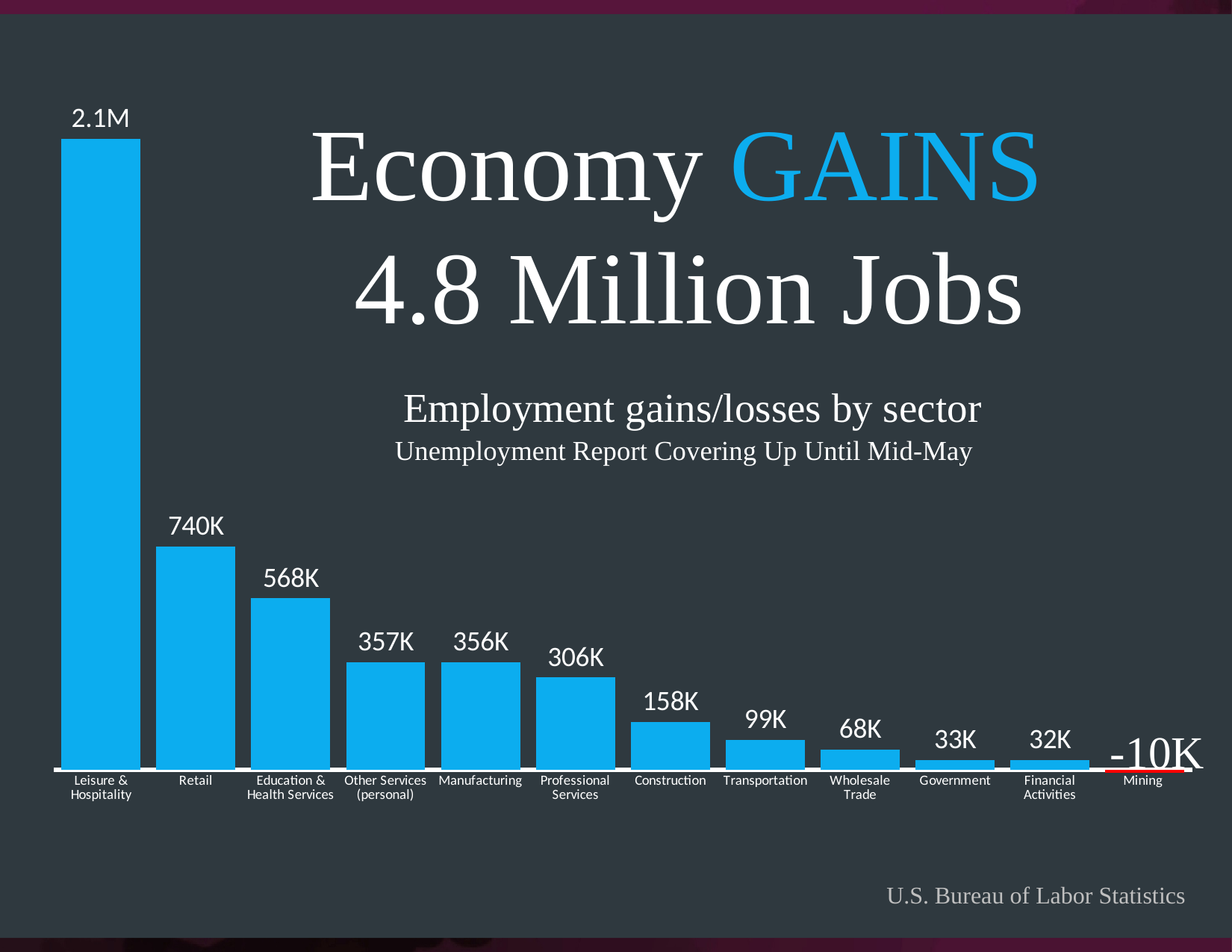
What is the value for Retail? 740K What kind of chart is shown on the slide? Bar chart Which is larger, the value for Transportation or the value for Wholesale Trade? Transportation How many sectors are shown in the chart? 12 Which sector has the lowest value? Mining What is the value for Construction? 158K What is the source cited for the chart data? U.S. Bureau of Labor Statistics What is the difference between the values for Retail and Education & Health Services? 172K Which sector has the highest value? Leisure & Hospitality Do the values rise or fall from left to right along the x axis? Fall What is the value for Government? 33K What is the value for Mining? -10K